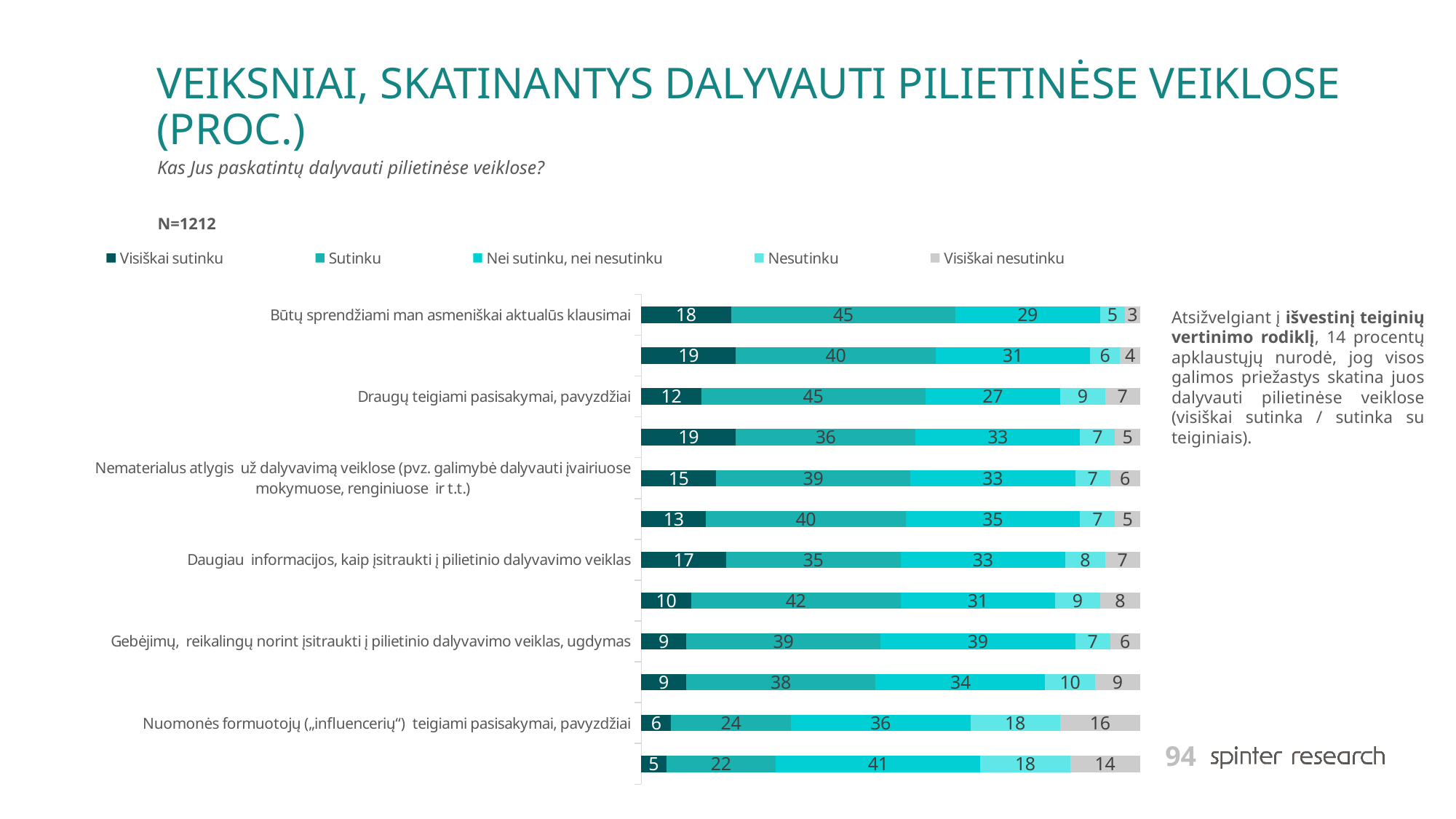
What is the "Visiškai sutinku" value for "Būtų sprendžiami man asmeniškai aktualūs klausimai"? 18 Which category has the lowest "Nesutinku" value? Būtų sprendžiami man asmeniškai aktualūs klausimai What sample size (N) is shown on the slide? N=1212 What is the "Nei sutinku, nei nesutinku" value for "Gebėjimų, reikalingų norint įsitraukti į pilietinio dalyvavimo veiklas, ugdymas"? 39 What kind of chart is shown on the slide? Stacked bar chart Which category has the highest "Visiškai nesutinku" value? Nuomonės formuotojų („influencerių“) teigiami pasisakymai, pavyzdžiai Which has the larger "Nei sutinku, nei nesutinku" value: "Nuomonės formuotojų („influencerių“) teigiami pasisakymai, pavyzdžiai" or "Būtų sprendžiami man asmeniškai aktualūs klausimai"? Nuomonės formuotojų („influencerių“) teigiami pasisakymai, pavyzdžiai What is the "Visiškai nesutinku" value for "Nuomonės formuotojų („influencerių“) teigiami pasisakymai, pavyzdžiai"? 16 What is the "Sutinku" value for "Draugų teigiami pasisakymai, pavyzdžiai"? 45 What is the total of the stacked bar for "Būtų sprendžiami man asmeniškai aktualūs klausimai"? 100 For "Nuomonės formuotojų („influencerių“) teigiami pasisakymai, pavyzdžiai", what is the difference between the "Sutinku" and "Visiškai sutinku" values? 18 How many series does the legend list? 5